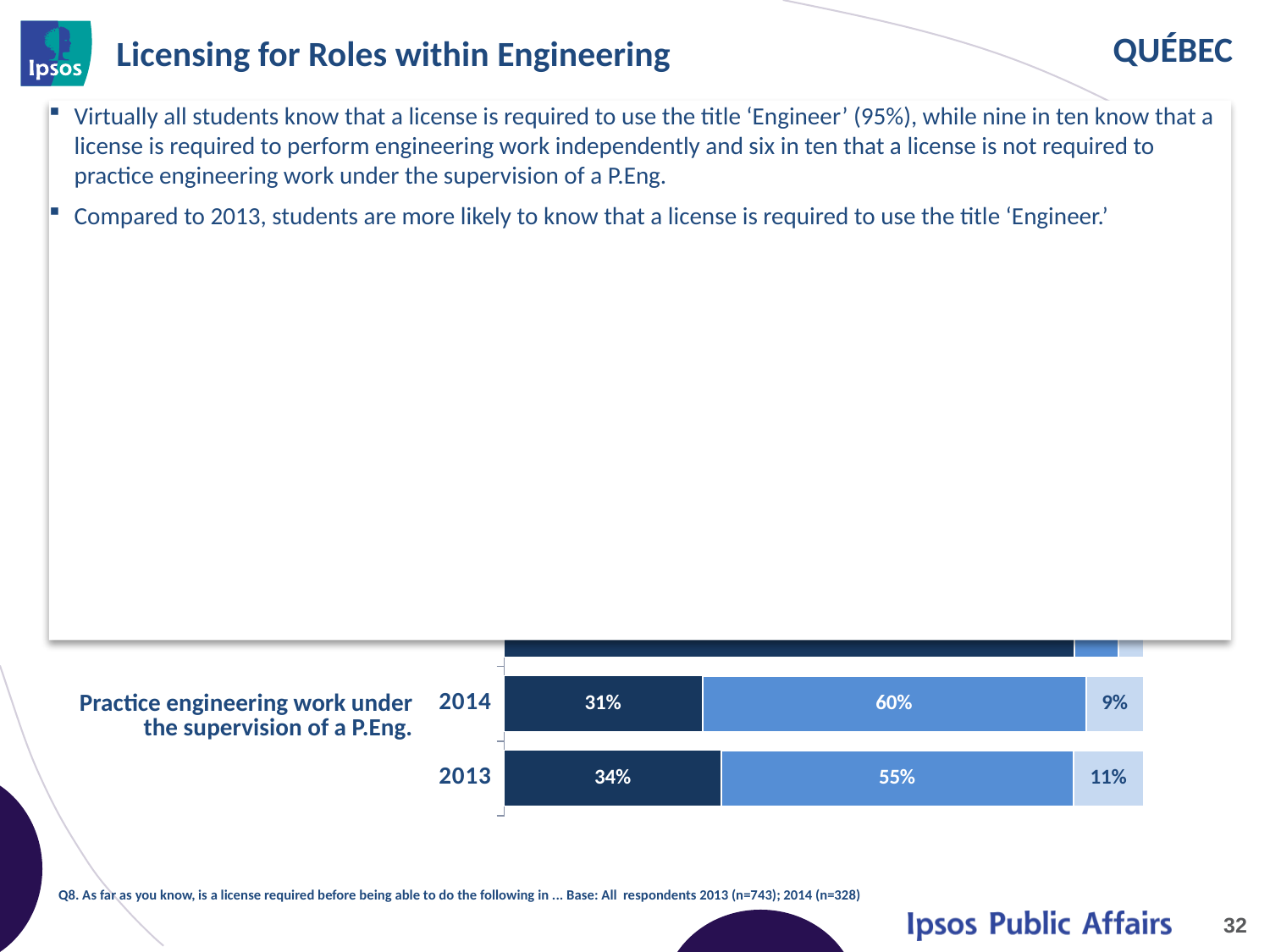
What kind of chart is shown on the slide? Stacked bar chart In the 'Practice engineering work under the supervision of a P.Eng.' bars, what is the value of the middle (medium blue) segment for 2013? 55% What is the total of the three segments in the 2014 bar for 'Practice engineering work under the supervision of a P.Eng.'? 100% In the 'Practice engineering work under the supervision of a P.Eng.' bars, what is the value of the last (light blue) segment for 2014? 9% In the 'Practice engineering work under the supervision of a P.Eng.' bars, what is the value of the first (dark blue) segment for 2014? 31% For 'Practice engineering work under the supervision of a P.Eng.', what is the difference between the first (dark blue) segment values for 2013 and 2014? 3 percentage points How many segments make up each bar for 'Practice engineering work under the supervision of a P.Eng.'? 3 For 'Practice engineering work under the supervision of a P.Eng.', which year has the larger middle (medium blue) segment, 2013 or 2014? 2014 For 'Practice engineering work under the supervision of a P.Eng.', which year has the larger first (dark blue) segment, 2013 or 2014? 2013 In the 'Practice engineering work under the supervision of a P.Eng.' bars, what is the value of the middle (medium blue) segment for 2014? 60% For 'Practice engineering work under the supervision of a P.Eng.', what is the difference between the middle segment values for 2014 and 2013? 5 percentage points In the 'Practice engineering work under the supervision of a P.Eng.' bars, what is the value of the last (light blue) segment for 2013? 11%